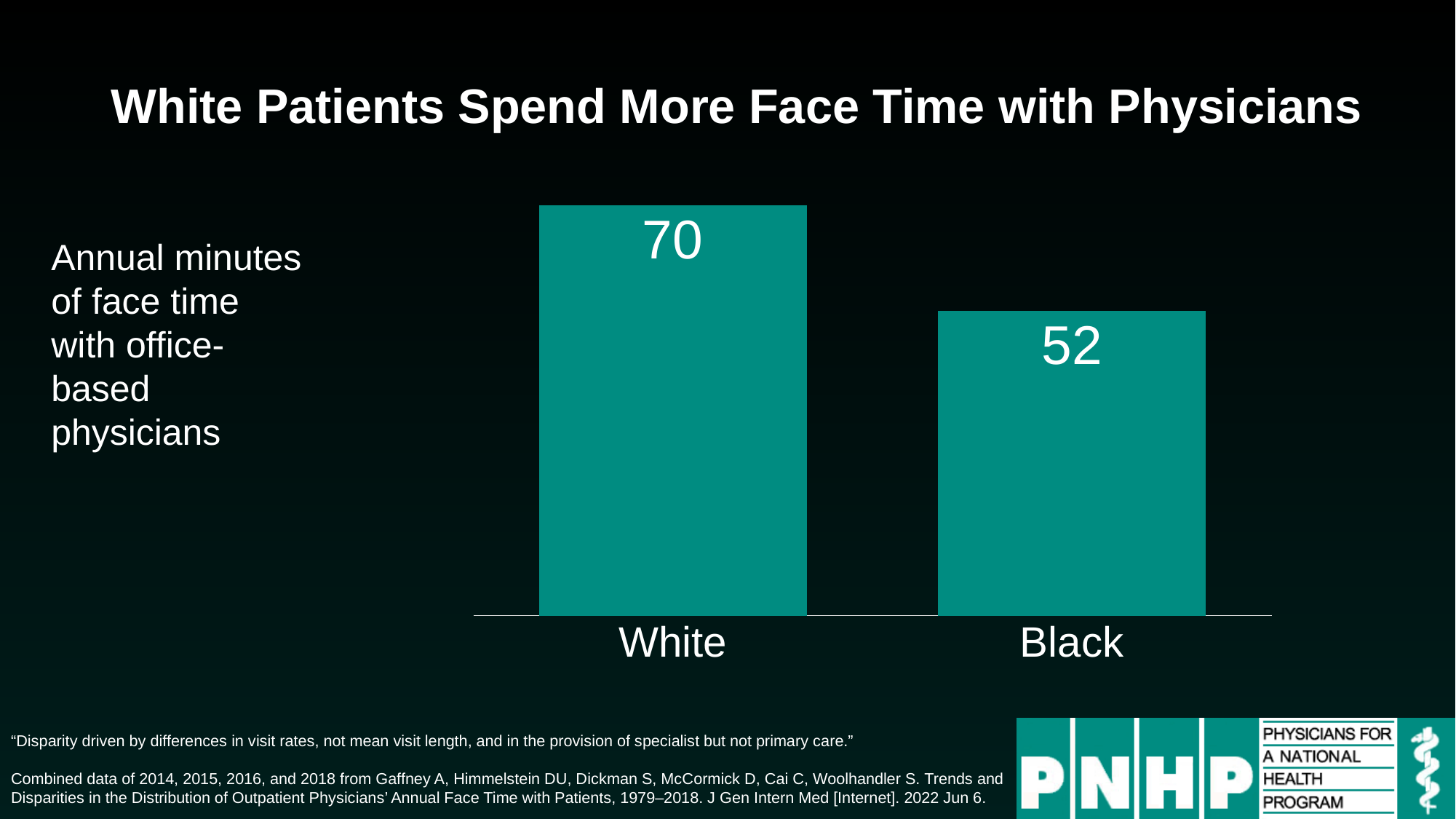
What kind of chart is shown on the slide? Bar chart What is the difference between the values for White and Black patients? 18 Which is larger, the value for White or for Black patients? White Which category has the lowest value? Black What is the value for White patients? 70 Which category has the highest value? White What is the title of the slide? White Patients Spend More Face Time with Physicians What is the value for Black patients? 52 How many categories are shown in the chart? 2 What quantity does the chart measure, according to the text on the left? Annual minutes of face time with office-based physicians